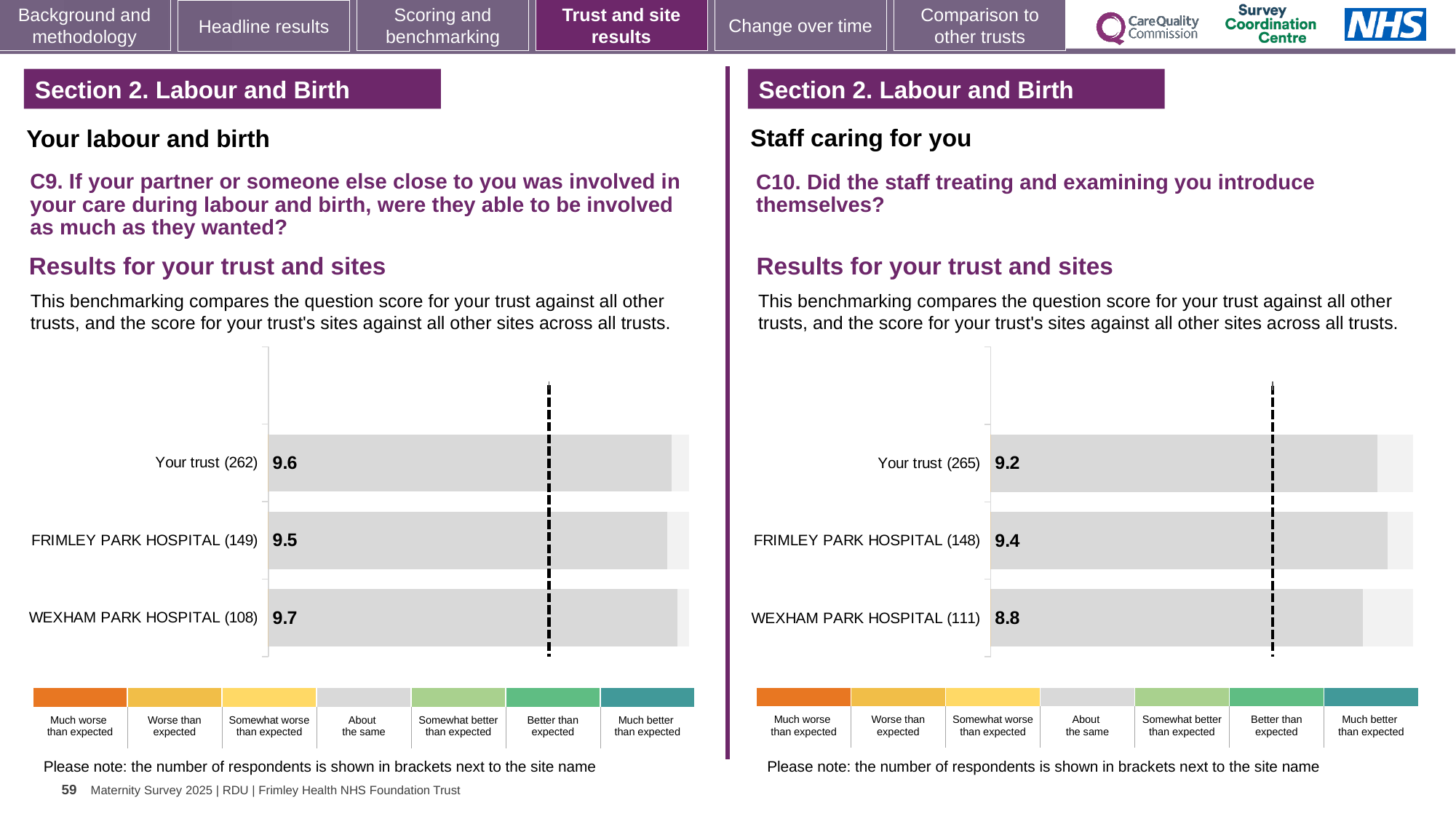
What type of chart is used in the C10 chart (right)? Bar chart In the C9 chart (left), what is the score for Your trust? 9.6 In the C9 chart (left), which site or trust has the highest score? WEXHAM PARK HOSPITAL In the C10 chart (right), how many respondents are shown in brackets for Your trust? 265 In the C10 chart (right), which has the larger score, Your trust or FRIMLEY PARK HOSPITAL? FRIMLEY PARK HOSPITAL In the C10 chart (right), which site or trust has the lowest score? WEXHAM PARK HOSPITAL How many bars are shown in the C9 chart (left)? 3 In the C10 chart (right), what is the difference between the scores for FRIMLEY PARK HOSPITAL and WEXHAM PARK HOSPITAL? 0.6 In the C10 chart (right), what is the score for FRIMLEY PARK HOSPITAL? 9.4 In the C9 chart (left), what is the difference between the scores for WEXHAM PARK HOSPITAL and FRIMLEY PARK HOSPITAL? 0.2 In the C10 chart (right), what is the score for WEXHAM PARK HOSPITAL? 8.8 In the C9 chart (left), what is the score for WEXHAM PARK HOSPITAL? 9.7